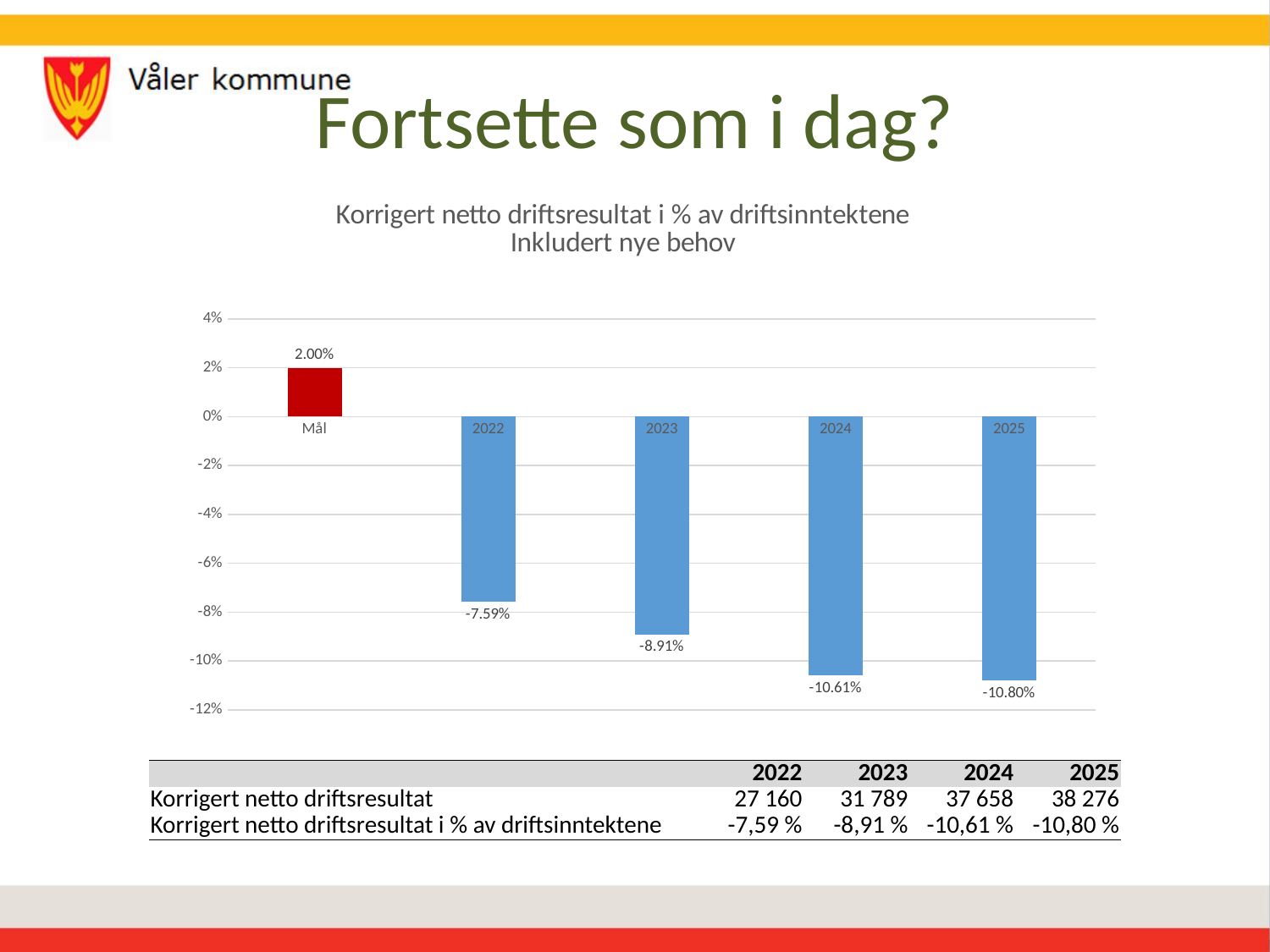
What is the value shown for 2025? -10.80% What is the value shown for 2022? -7.59% Is the value for 2023 greater or less than -10%? greater Which category has the lowest value? 2025 How many bars are plotted in the chart? 5 What kind of chart is shown on the slide? Bar chart What is the value of the Mål bar? 2.00% What is the value shown for 2024? -10.61% Do the values rise or fall from 2022 to 2025? Fall Which category has the highest value? Mål What is the difference between the values for 2022 and 2023? 1.32 percentage points Which is larger, the value for 2023 or the value for 2024? 2023